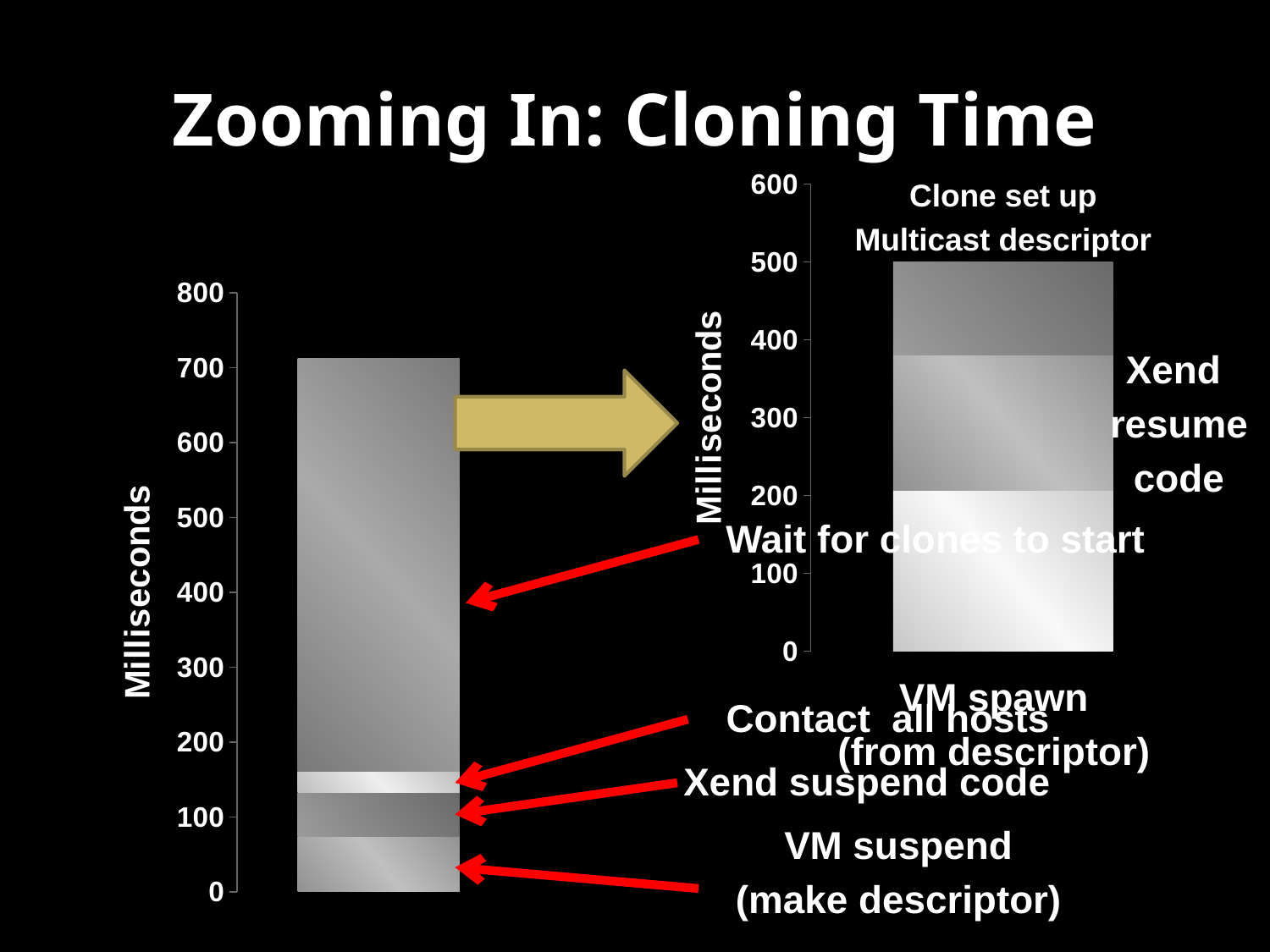
In the right chart, is the total height of the stacked bar greater or less than 600? less In the left chart, is the total height of the stacked bar greater or less than 600? greater In the left chart, is the top of the 'VM suspend (make descriptor)' segment greater or less than 100? less How many labelled segments make up the stacked bar in the left chart? 4 How many labelled segments make up the stacked bar in the right chart? 3 What is the y-axis title of the left chart? Milliseconds What kind of chart is the left chart on the slide? bar chart What is the highest tick value shown on the y-axis of the right chart? 600 What kind of chart is the right chart on the slide? bar chart